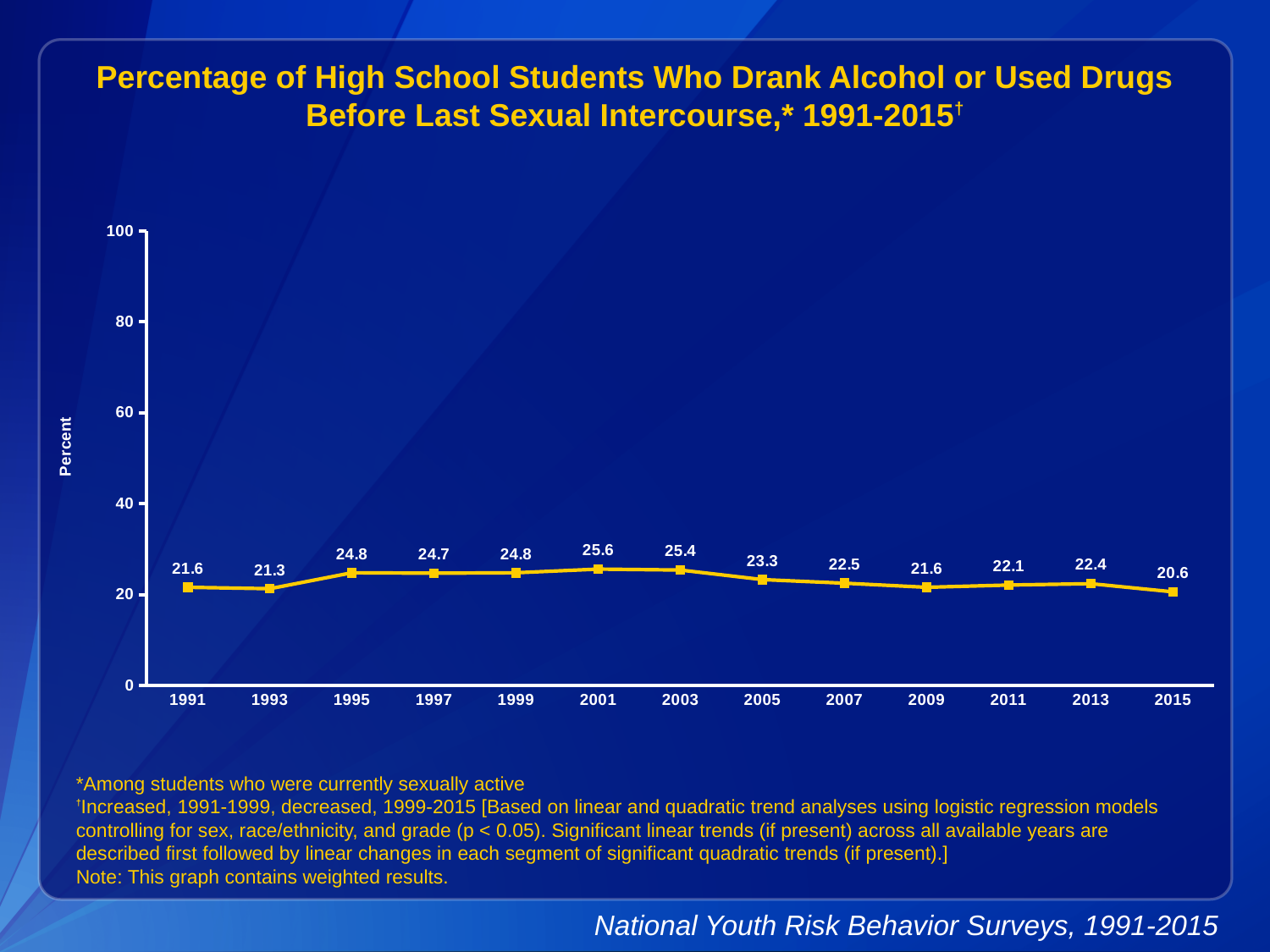
Is the value for 2003 greater or less than 40? less What kind of chart is shown on the slide? line chart What is the label on the y axis? Percent Which year has a larger value, 1995 or 2005? 1995 Which year has the lowest value on the chart? 2015 What value is shown for 2015? 20.6 What value is shown for 2001? 25.6 What is the difference between the values for 2001 and 2015? 5.0 How many years are plotted on the chart? 13 Did the values rise or fall from 2003 to 2015? fall What was the percentage of high school students who drank alcohol or used drugs before last sexual intercourse in 1991? 21.6 Which year has the highest value on the chart? 2001